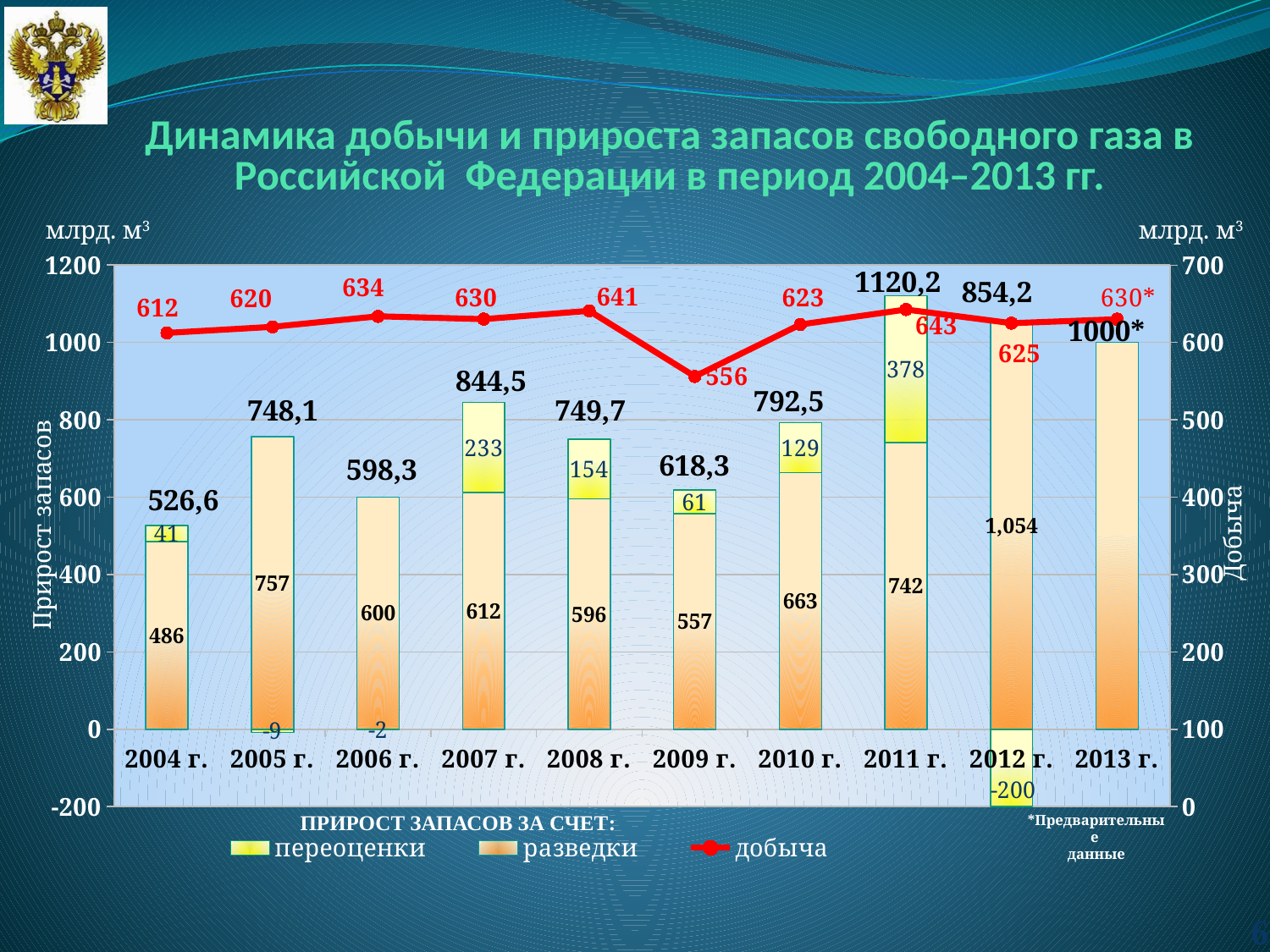
What is the total прирост запасов labelled above the bar for 2007 г.? 844,5 What is the difference between the total прирост запасов for 2011 г. and 2010 г.? 327,7 How many series does the legend list? 3 Which year has the highest total прирост запасов? 2011 г. How many years are shown on the x axis? 10 What kind of chart is shown on the slide? Combined stacked bar and line chart What is the value of the переоценки segment for 2012 г.? -200 What is the value of the разведки segment for 2011 г.? 742 What is the value of добыча (the red line) for 2009 г.? 556 In which year is добыча (the red line) lowest? 2009 г. Which year has the larger разведки segment, 2005 г. or 2010 г.? 2005 г. By how much did добыча fall from 2008 г. to 2009 г.? 85